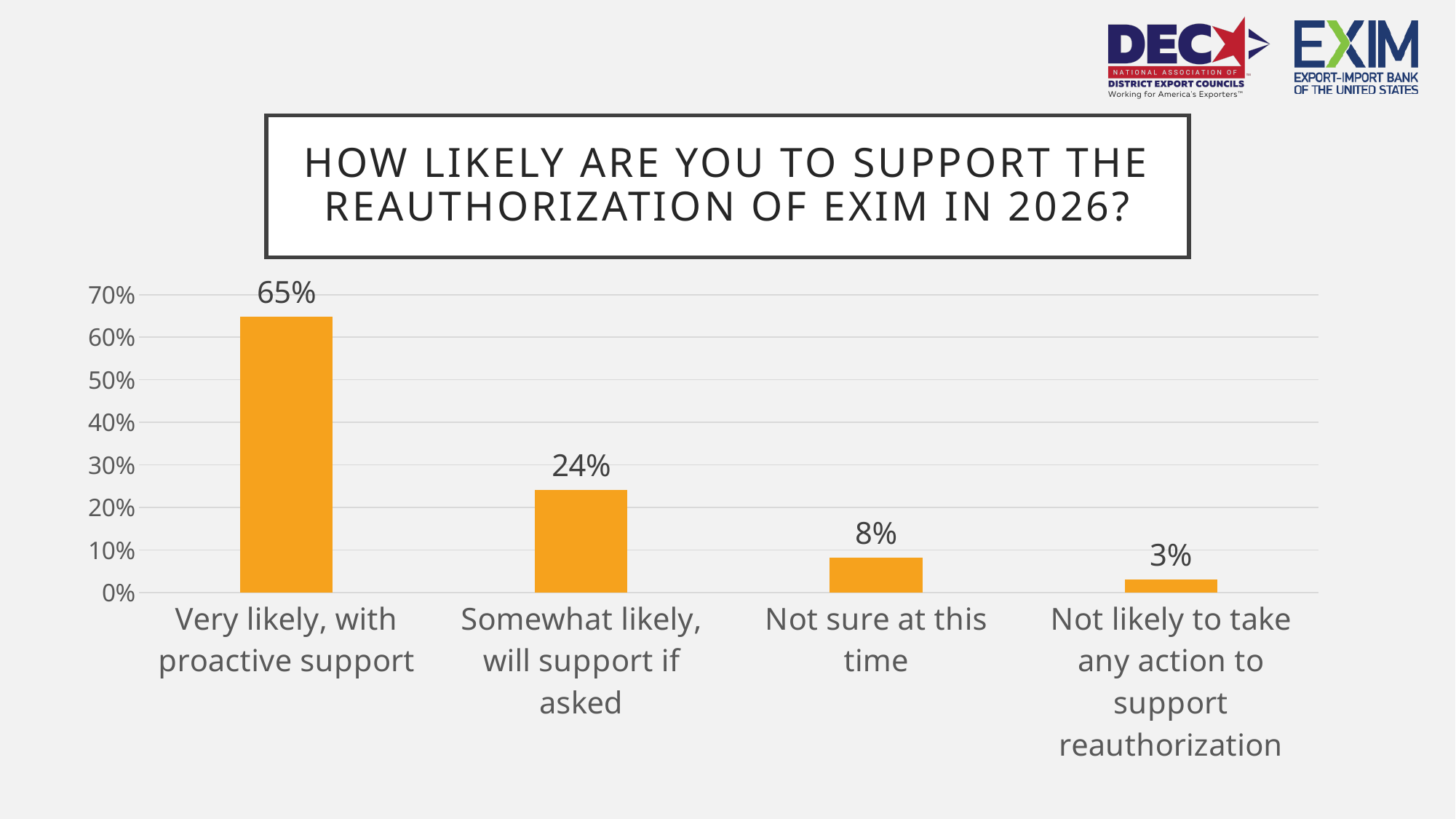
What is the value for "Somewhat likely, will support if asked"? 24% What is the difference between the "Very likely, with proactive support" and "Somewhat likely, will support if asked" values? 41% Which is larger: the value for "Not sure at this time" or for "Not likely to take any action to support reauthorization"? Not sure at this time Do the values rise or fall moving from left to right across the categories? Fall What is the value for "Not likely to take any action to support reauthorization"? 3% Which response category has the lowest value? Not likely to take any action to support reauthorization How many response categories are shown in the chart? 4 Which response category has the highest value? Very likely, with proactive support What kind of chart is shown on the slide? Bar chart What percentage of respondents said they are very likely to support reauthorization with proactive support? 65% What percentage of respondents are not sure at this time? 8% Is the value for "Somewhat likely, will support if asked" greater or less than 30%? less